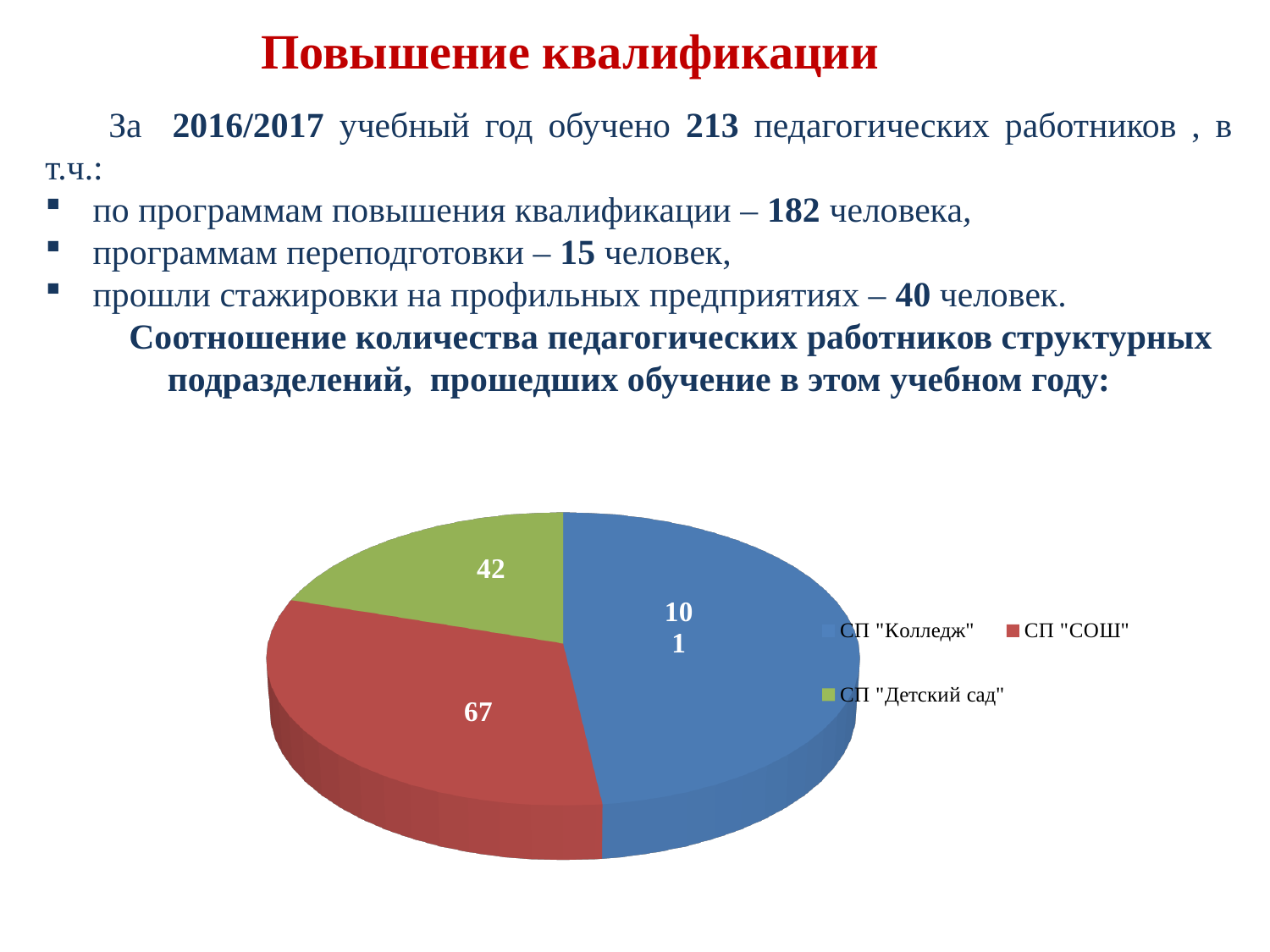
What colour is the slice for СП "Детский сад"? green What is the value for СП "СОШ" in the pie chart? 67 Which is larger in the pie chart: СП "СОШ" or СП "Детский сад"? СП "СОШ" What is the value for СП "Детский сад" in the pie chart? 42 What colour is the slice for СП "СОШ"? red How many entries does the legend of the pie chart list? 3 Which structural unit has the largest slice in the pie chart? СП "Колледж" What kind of chart is shown on the slide? pie chart What is the difference between the values for СП "СОШ" and СП "Детский сад"? 25 How many slices does the pie chart have? 3 Which structural unit has the smallest slice in the pie chart? СП "Детский сад" What is the value for СП "Колледж" in the pie chart? 101